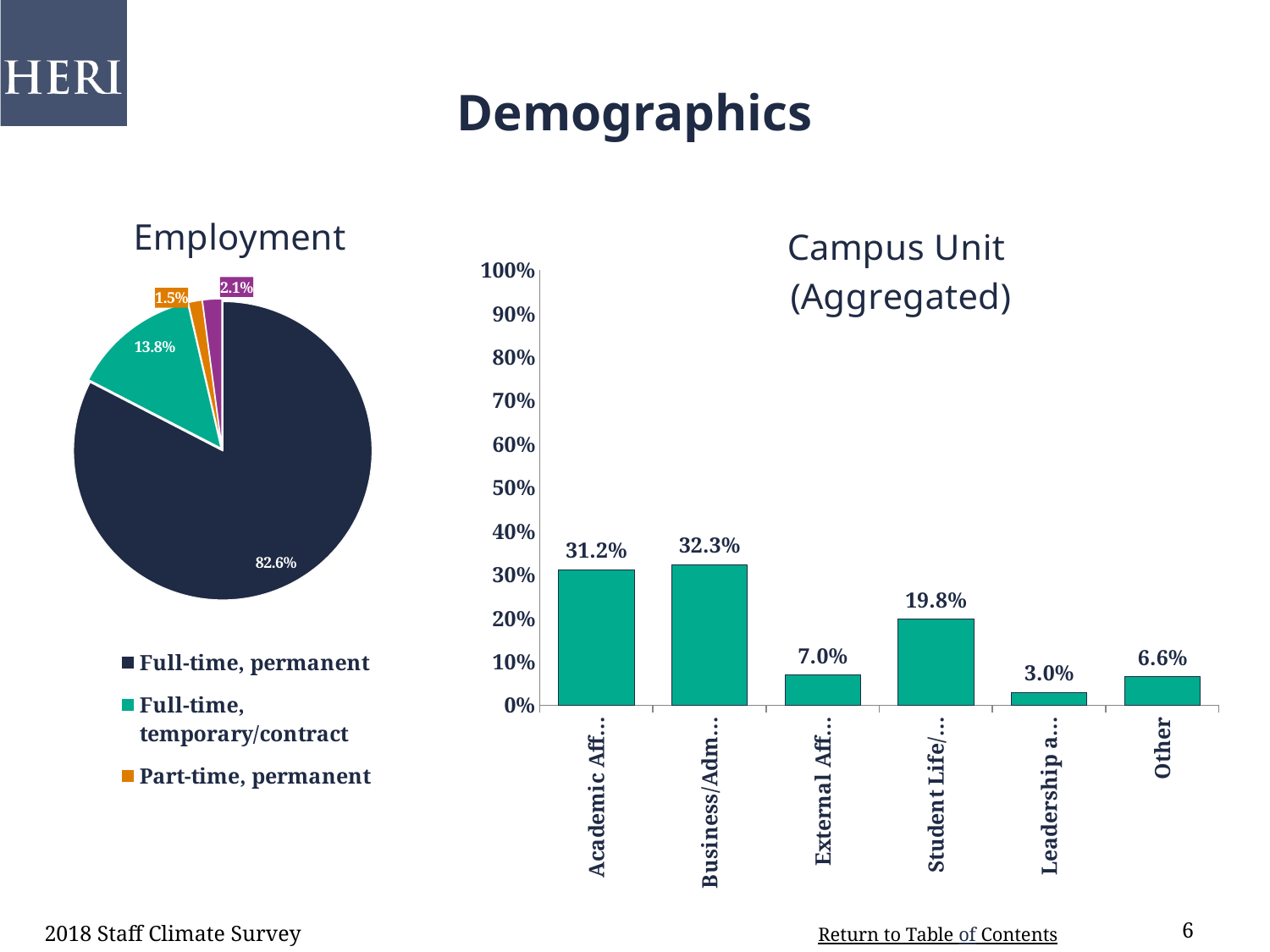
How many bars are in the Campus Unit (Aggregated) chart? 6 In the Campus Unit (Aggregated) chart, which category has the highest value? Business/Adm... In the Campus Unit (Aggregated) chart, what is the difference between the Business/Adm... bar and the Academic Aff... bar? 1.1% In the Employment pie chart, what share is Full-time, temporary/contract? 13.8% In the Campus Unit (Aggregated) chart, which category has the lowest value? Leadership a... In the Campus Unit (Aggregated) chart, what is the value for Other? 6.6% In the Campus Unit (Aggregated) chart, what is the value for the Student Life/... bar? 19.8% In the Employment pie chart, what share is Part-time, permanent? 1.5% In the Employment pie chart, which category has the largest slice? Full-time, permanent What kind of chart is the Employment chart? Pie chart In the Campus Unit (Aggregated) chart, which is larger, External Aff... or Other? External Aff... In the Employment pie chart, what share is Full-time, permanent? 82.6%